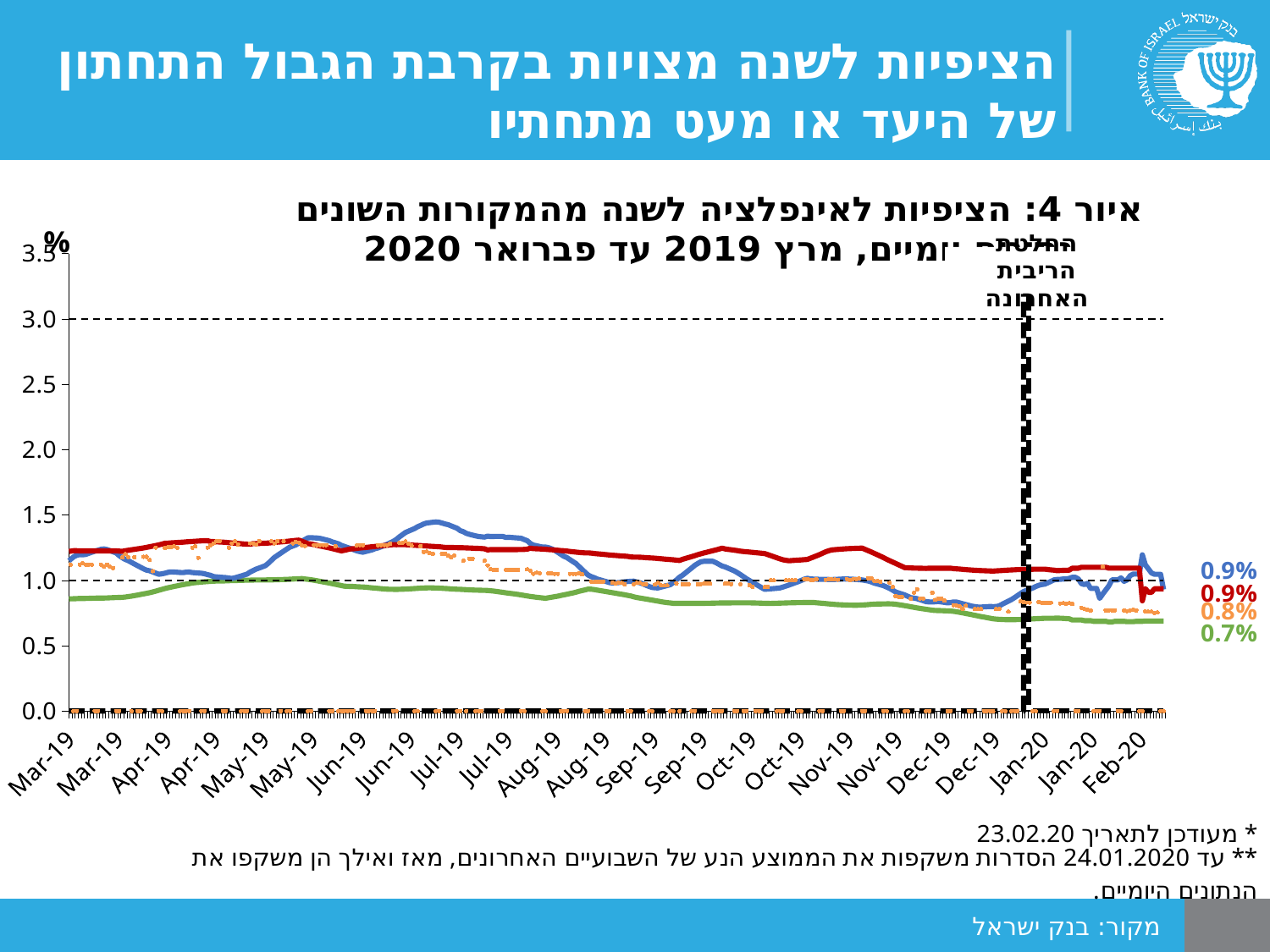
Is the end value of the red line greater or less than the end value of the orange dashed line? greater Does the green line rise or fall between May-19 and Feb-20? fall How many lines are plotted on the chart? 4 Which line has the lowest labelled end value? the green line (0.7%) Is the value of the red line in Apr-19 greater or less than 1.0? greater What is the final value labelled at the end of the blue line? 0.9% What is the final value labelled at the end of the green line? 0.7% What type of chart is shown on the slide? line chart What is the difference between the end value of the red line and the end value of the green line? 0.2% What is the final value labelled at the end of the red line? 0.9% What is the final value labelled at the end of the orange dashed line? 0.8%